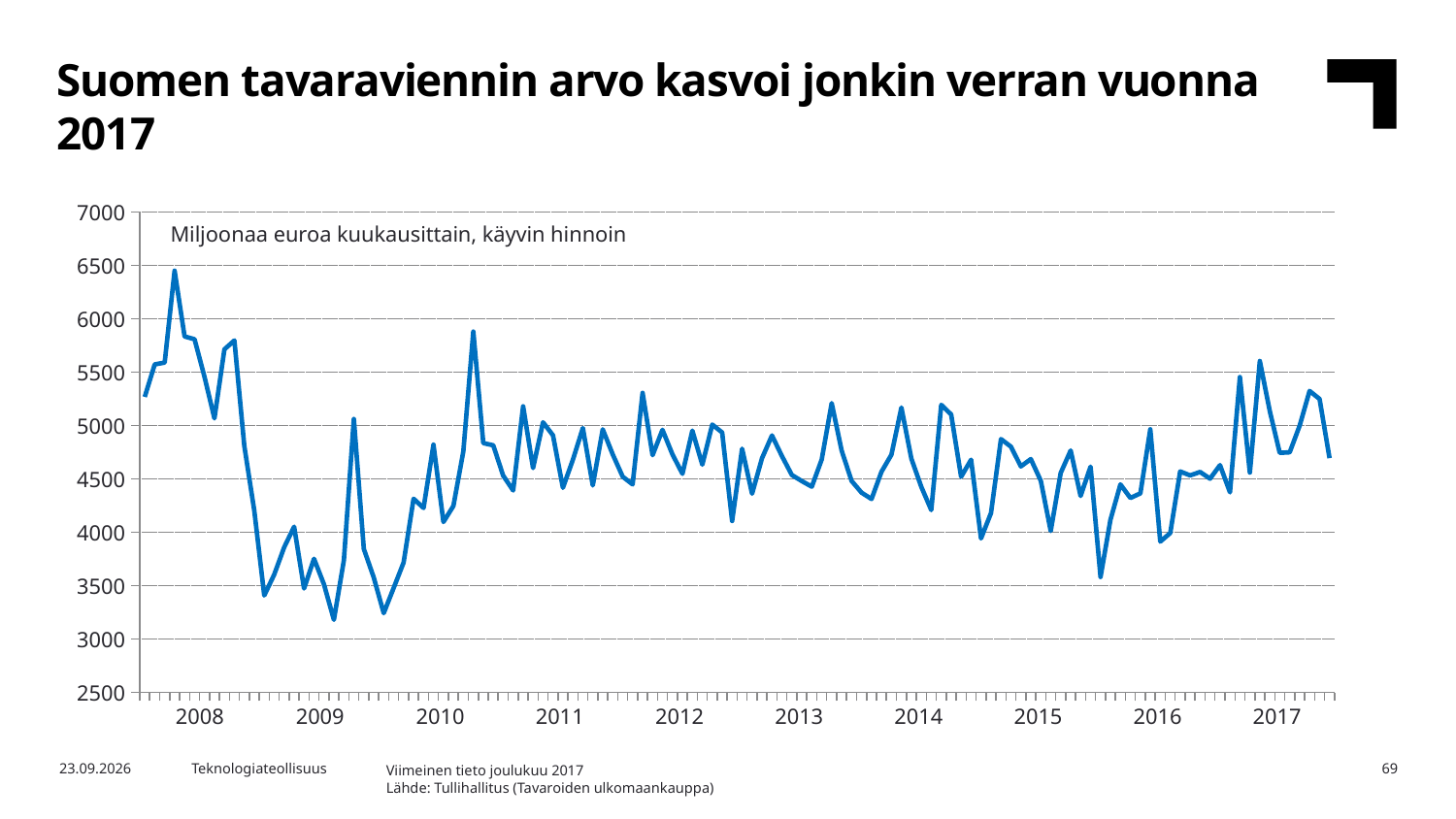
What unit description is printed inside the chart area? Miljoonaa euroa kuukausittain, käyvin hinnoin In which year does the line reach its highest value? 2008 Is the peak value reached in 2010 greater or less than 5500? greater Is the lowest value reached in 2015 greater or less than 4000? less Is the lowest value reached in 2009 greater or less than 3500? less What kind of chart is shown on the slide? line chart What is the title of the slide? Suomen tavaraviennin arvo kasvoi jonkin verran vuonna 2017 In which year does the line reach its lowest value? 2009 How many years are labelled on the x axis? 10 Do the values rise or fall from the peak in 2008 to the start of 2009? fall